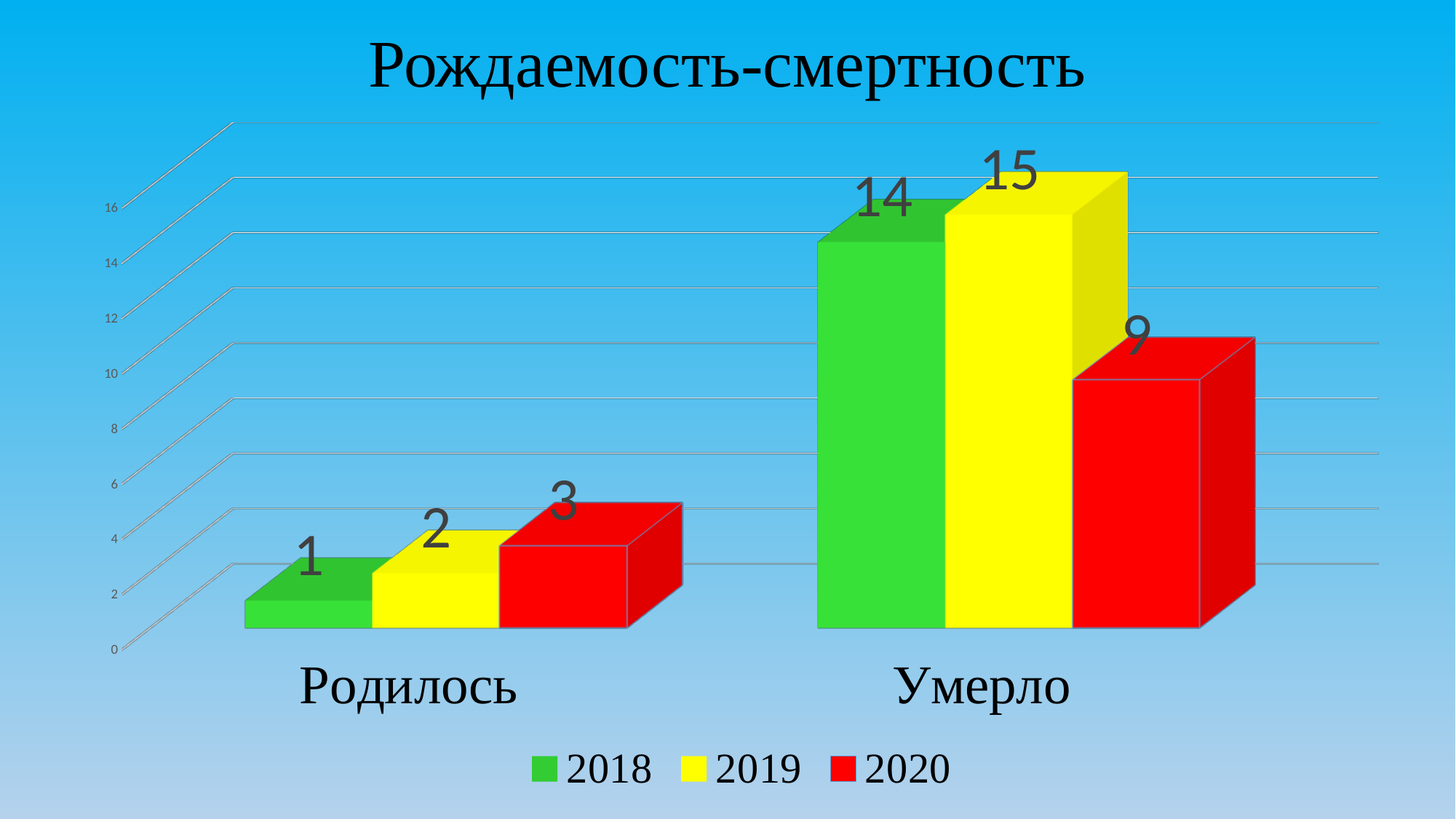
How many series does the legend list? 3 What is the value for 2018 in the Родилось category? 1 How many categories are shown on the x axis? 2 Which year has the highest value in the Умерло category? 2019 What is the title of the chart? Рождаемость-смертность What is the value for 2019 in the Умерло category? 15 Which year has the lowest value in the Родилось category? 2018 What is the value for 2020 in the Умерло category? 9 What is the difference between the 2018 and 2020 values in the Умерло category? 5 Which colour represents the 2019 series in the legend? Yellow What kind of chart is shown on the slide? Bar chart Which is larger: the 2020 value for Родилось or the 2020 value for Умерло? Умерло